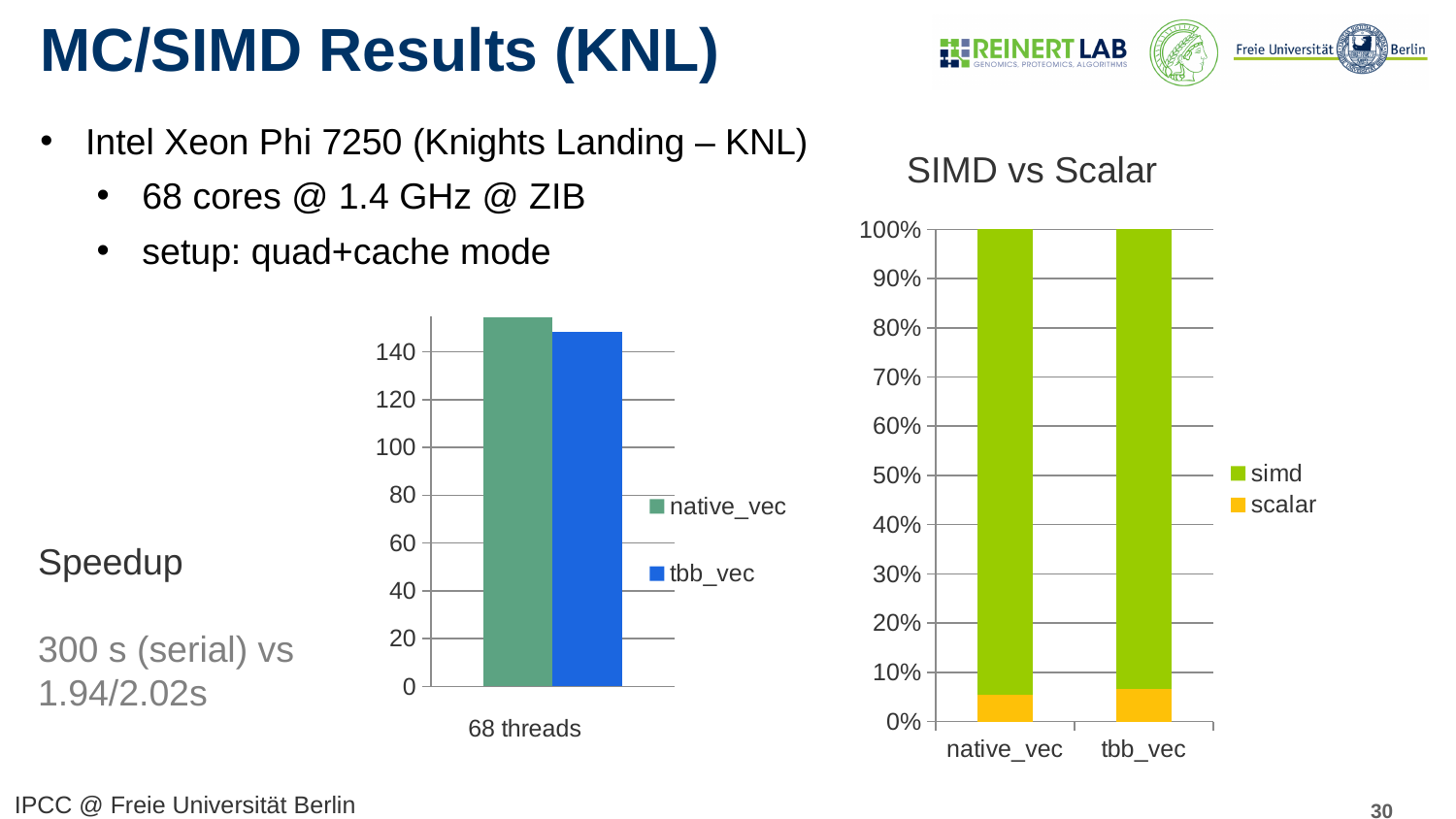
What kind of chart is the SIMD vs Scalar chart? stacked bar chart In the SIMD vs Scalar chart, is the scalar share for native_vec greater or less than 10%? less In the Speedup chart, which series has the higher bar, native_vec or tbb_vec? native_vec How many categories are shown on the x axis of the SIMD vs Scalar chart? 2 How many series does the legend of the Speedup chart list? 2 What is the title of the chart on the right of the slide? SIMD vs Scalar How many series does the legend of the SIMD vs Scalar chart list? 2 In the Speedup chart, is the value for native_vec greater or less than 140? greater In the SIMD vs Scalar chart, is the simd share for tbb_vec greater or less than 90%? greater What kind of chart is the Speedup chart on the left of the slide? bar chart What is the x-axis category label in the Speedup chart? 68 threads